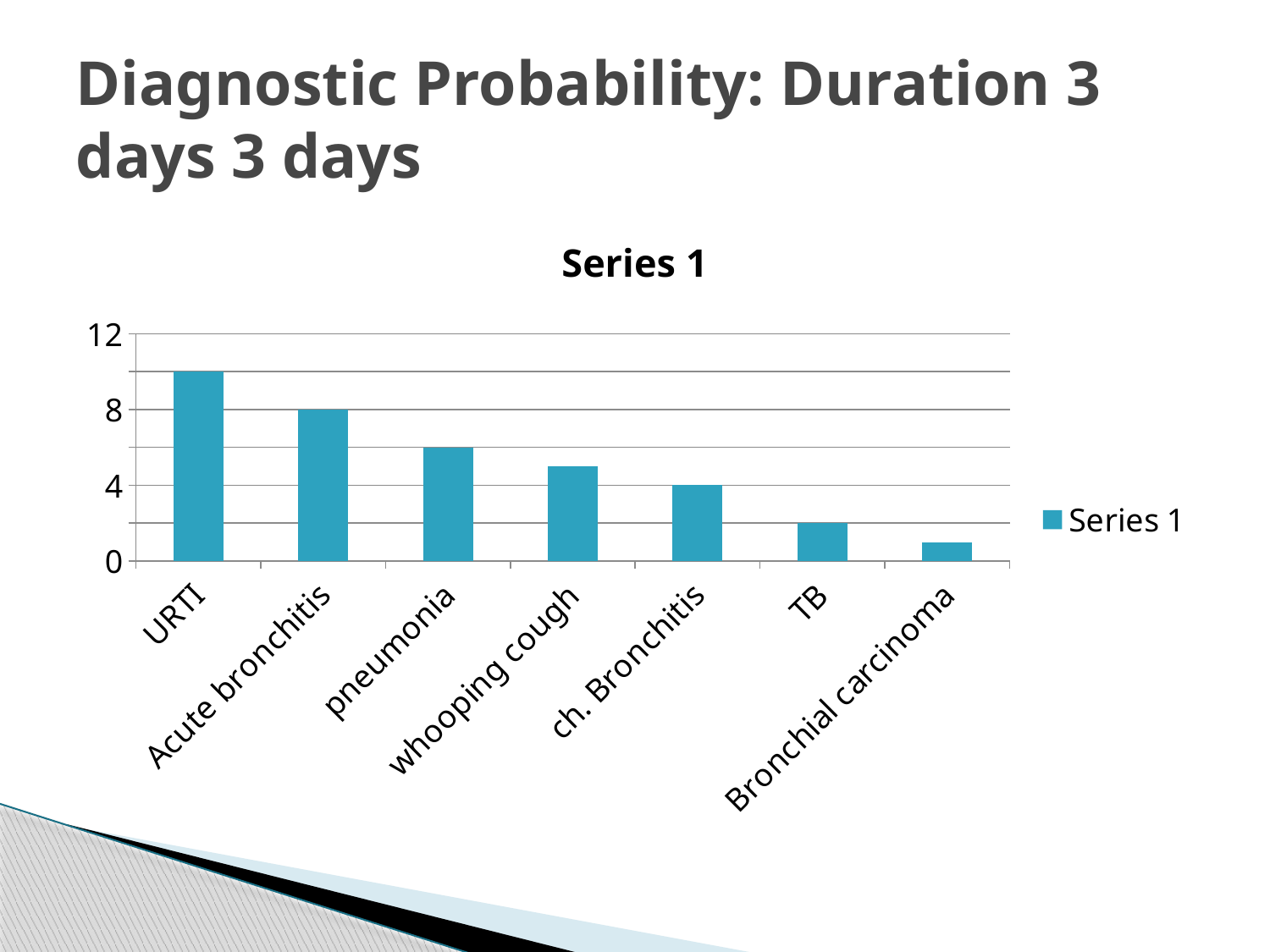
Which is larger, the value for pneumonia or the value for TB? pneumonia Which category has the lowest value? Bronchial carcinoma Is the value for TB greater or less than 4? less What is the value for Acute bronchitis? 8 What is the value for ch. Bronchitis? 4 Which category has the highest value? URTI Is the value for URTI greater or less than 8? greater What type of chart is shown on the slide? bar chart How many series does the legend list? 1 What is the difference between the values for Acute bronchitis and ch. Bronchitis? 4 Do the values rise or fall moving from left to right along the x axis? fall How many categories are shown on the x axis of the chart? 7